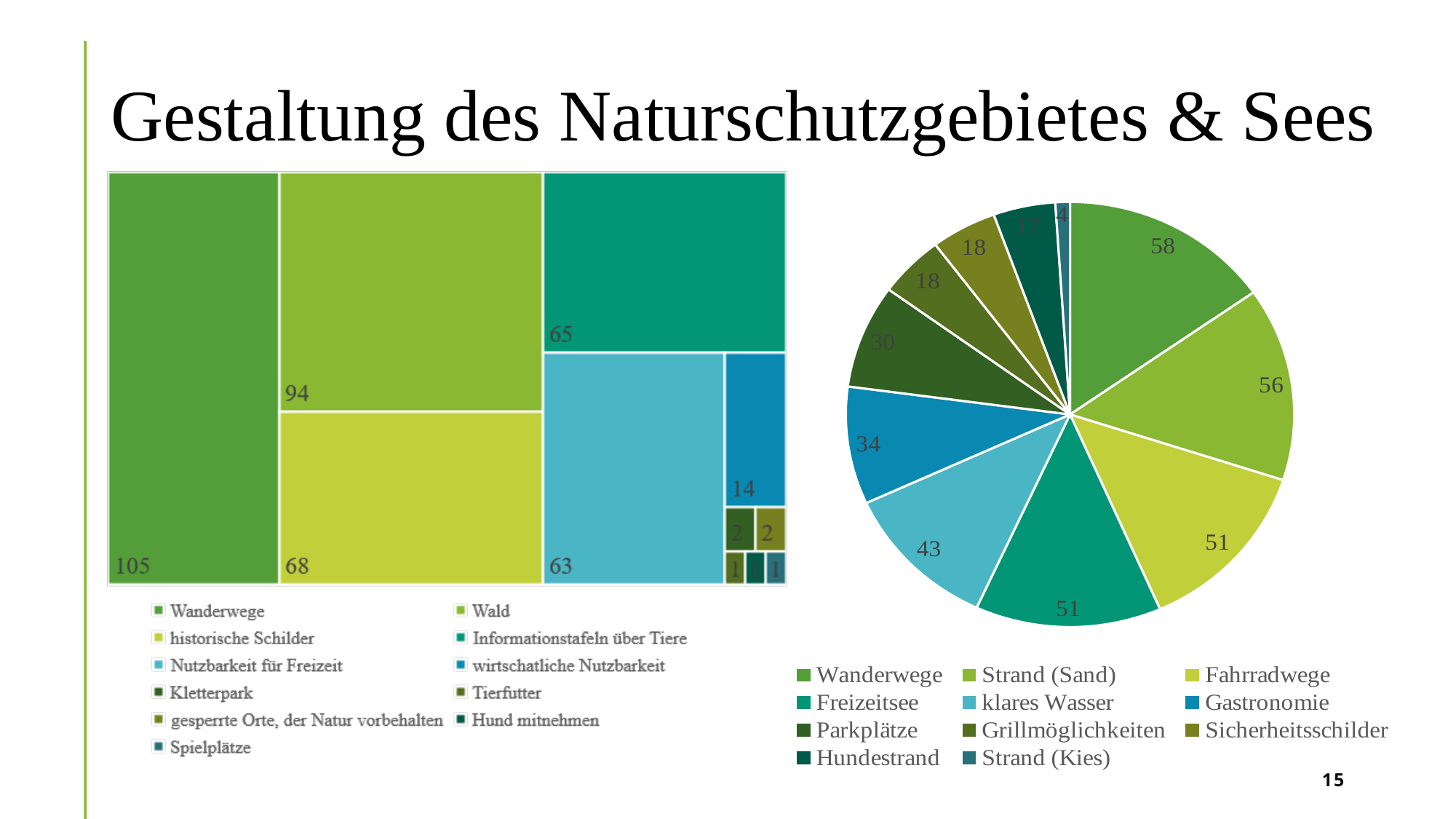
In the pie chart on the right, which category has the largest slice? Wanderwege In the treemap on the left, what is the value for Wald? 94 What kind of chart is shown on the right side of the slide? Pie chart In the treemap on the left, what is the value for Wanderwege? 105 In the pie chart on the right, which category has the smallest slice? Strand (Kies) In the pie chart on the right, which is larger: Freizeitsee or Gastronomie? Freizeitsee In the treemap on the left, how many categories does the legend list? 11 In the pie chart on the right, what is the difference between the values for klares Wasser and Parkplätze? 13 In the treemap on the left, which category has the highest value? Wanderwege In the treemap on the left, what is the difference between the values for Wanderwege and Wald? 11 In the treemap on the left, what is the value for wirtschaftliche Nutzbarkeit? 14 In the pie chart on the right, what is the value for Gastronomie? 34